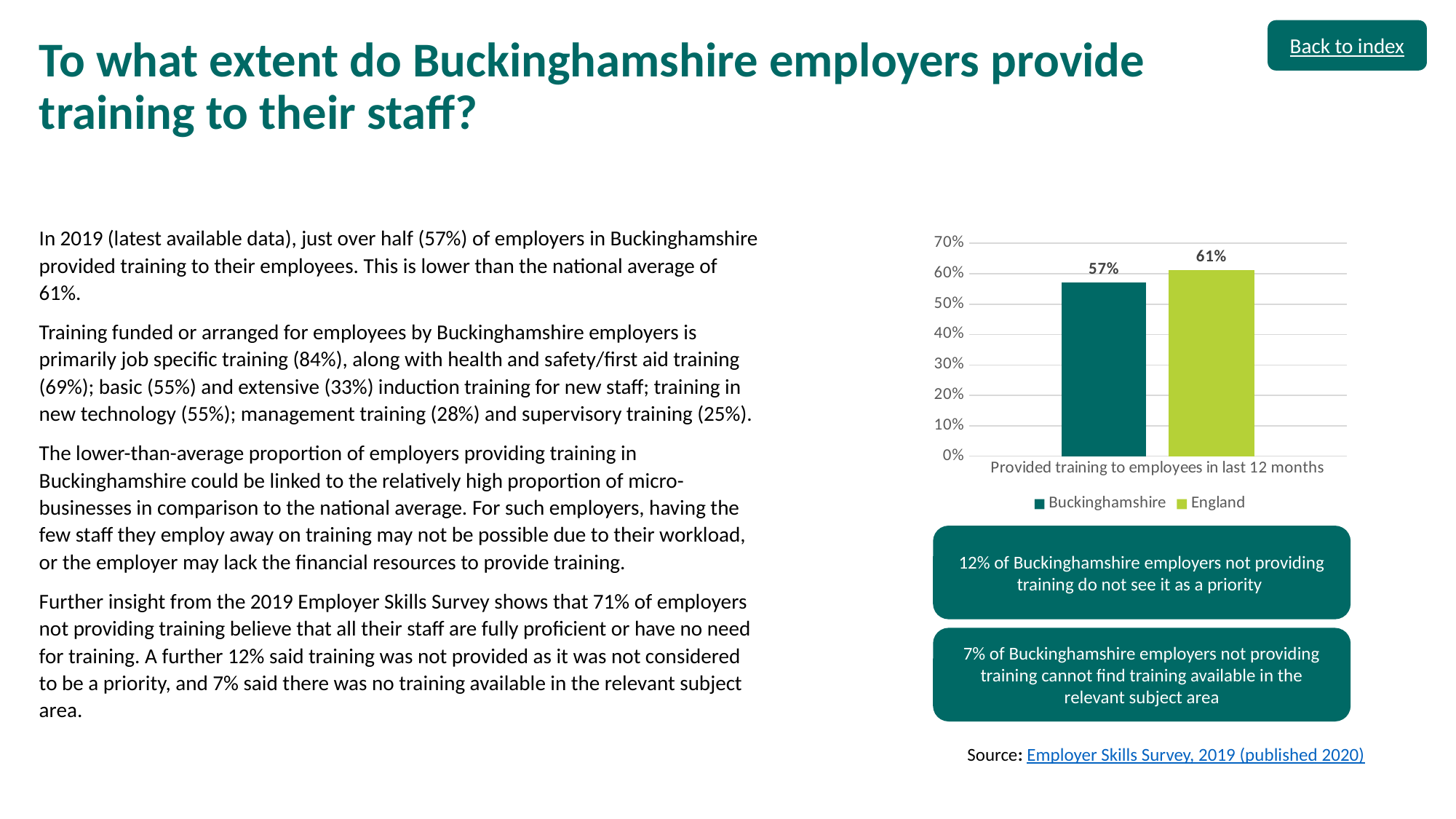
What is the category label on the x axis of the chart? Provided training to employees in last 12 months Is the value for Buckinghamshire greater or less than 50%? greater What kind of chart is shown on the slide? Bar chart How many series does the chart legend list? 2 What value does the chart show for Buckinghamshire? 57% What is the highest value shown on the chart's y axis? 70% How many categories are shown on the x axis of the chart? 1 What value does the chart show for England? 61% Which series has the higher value in the chart, Buckinghamshire or England? England Is the value for England greater or less than 70%? less What is the difference between the England value and the Buckinghamshire value in the chart? 4% Which series has the lowest value in the chart? Buckinghamshire